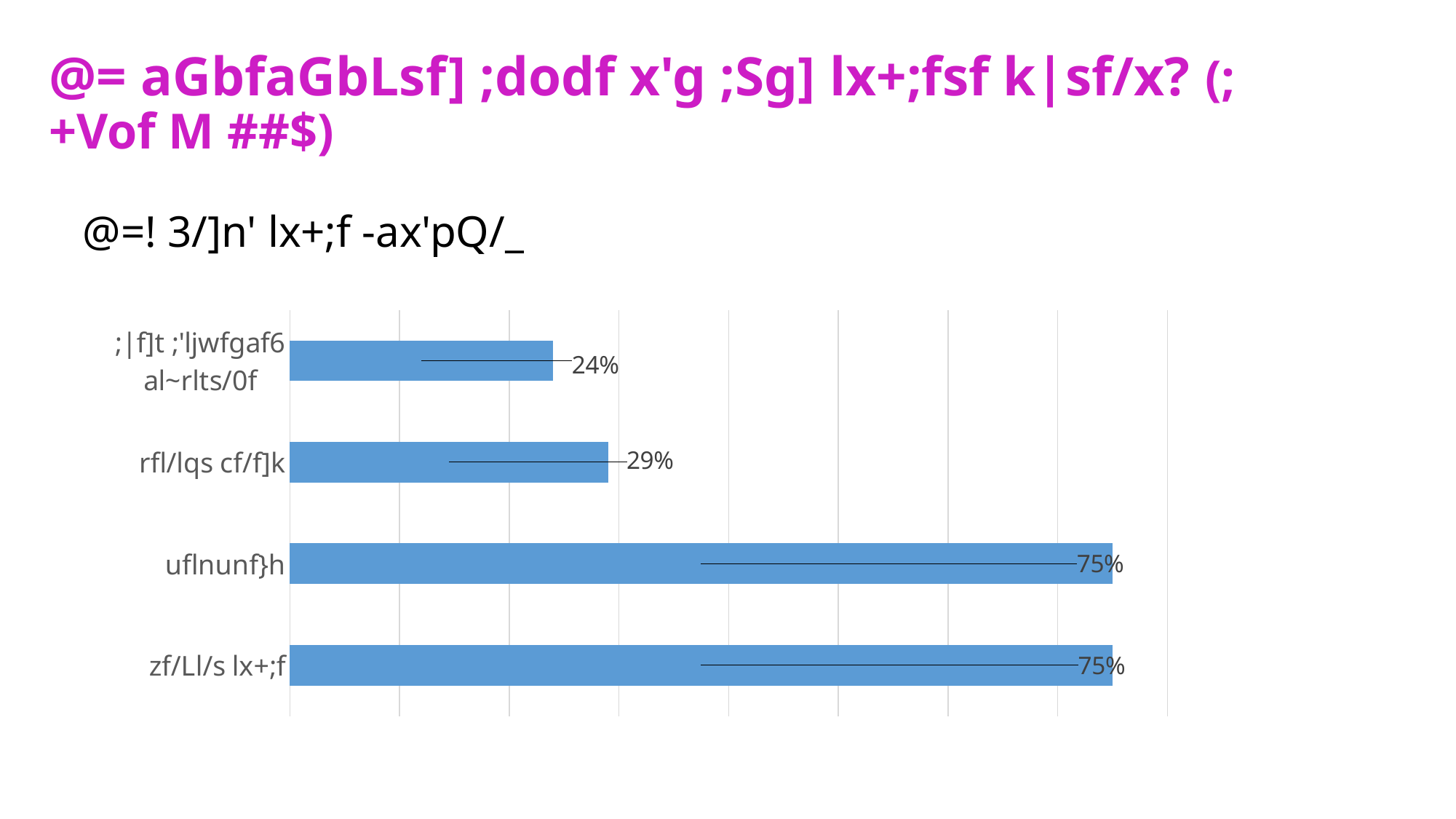
Which category has the lowest value? ;|f]t ;'ljwfgaf6 al~rlts/0f What is the value for the category ";|f]t ;'ljwfgaf6 al~rlts/0f"? 24% What is the value for the category "rfl/lqs cf/f]k"? 29% What is the value for the category "zf/Ll/s lx+;f"? 75% What kind of chart is shown on the slide? bar chart What is the difference between the values for "uflnunf}h" and "rfl/lqs cf/f]k"? 46% What is the difference between the values for "rfl/lqs cf/f]k" and ";|f]t ;'ljwfgaf6 al~rlts/0f"? 5% What colour are the bars in the chart? blue How many categories share the highest value of 75%? 2 How many categories does the bar chart show? 4 What is the value for the category "uflnunf}h"? 75% Which is larger, the value for "uflnunf}h" or the value for "rfl/lqs cf/f]k"? uflnunf}h